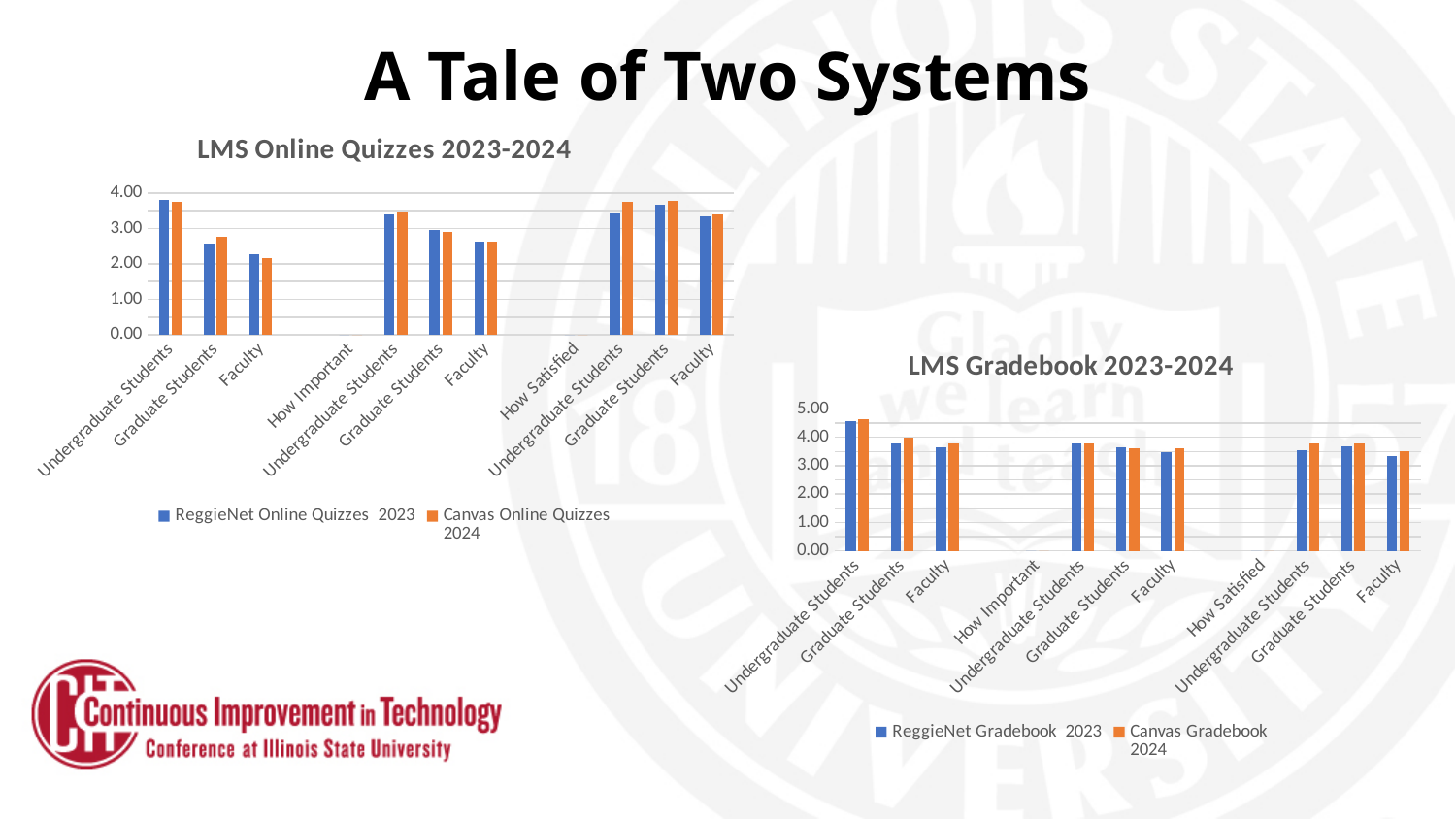
In the 'LMS Online Quizzes 2023-2024' chart, what are the two legend entries? ReggieNet Online Quizzes 2023 and Canvas Online Quizzes 2024 In the 'LMS Gradebook 2023-2024' chart, is the ReggieNet Gradebook 2023 value for the rightmost Faculty category greater or less than 4.00? less In the 'LMS Gradebook 2023-2024' chart, which is larger for ReggieNet Gradebook 2023: the leftmost Undergraduate Students bar or the leftmost Graduate Students bar? Undergraduate Students In the 'LMS Gradebook 2023-2024' chart, is the ReggieNet Gradebook 2023 value for the leftmost Undergraduate Students category greater or less than 4.00? greater How many series does the legend of the 'LMS Gradebook 2023-2024' chart list? 2 In the 'LMS Online Quizzes 2023-2024' chart, is the ReggieNet Online Quizzes 2023 value for the leftmost Faculty category greater or less than 3.00? less In the 'LMS Gradebook 2023-2024' chart, which category has the highest ReggieNet Gradebook 2023 bar? Undergraduate Students (leftmost) What is the highest value shown on the vertical axis of the 'LMS Gradebook 2023-2024' chart? 5.00 What kind of chart is the 'LMS Online Quizzes 2023-2024' chart? bar chart In the 'LMS Online Quizzes 2023-2024' chart, which is larger for ReggieNet Online Quizzes 2023: the leftmost Undergraduate Students bar or the leftmost Faculty bar? Undergraduate Students